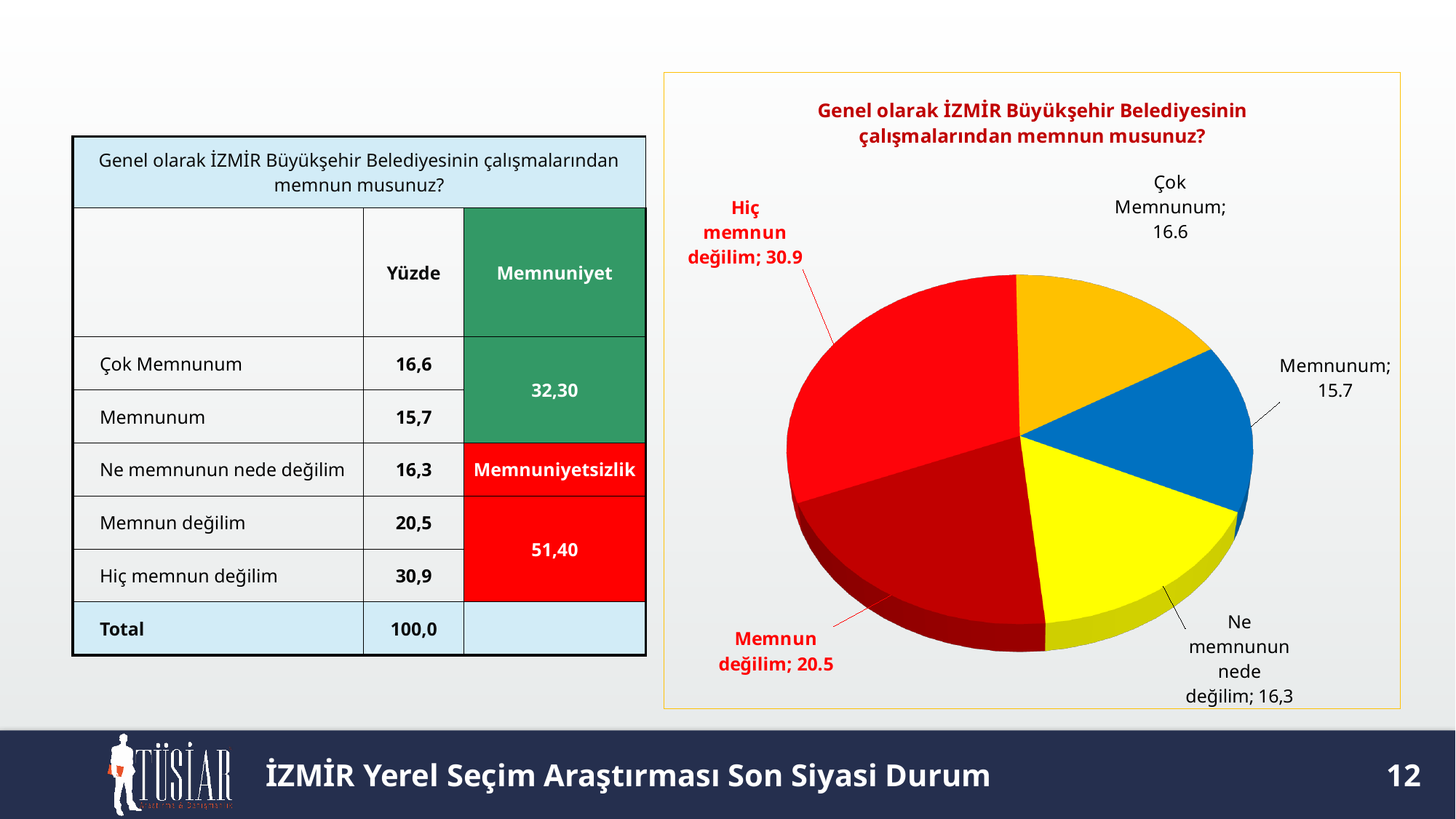
What is the value shown for Memnunum in the pie chart? 15.7 How many slices does the pie chart have? 5 What is the value shown for Ne memnunun nede değilim in the pie chart? 16,3 Which category has the largest slice in the pie chart? Hiç memnun değilim What is the value shown for Hiç memnun değilim in the pie chart? 30.9 What is the difference between the values for Hiç memnun değilim and Memnun değilim in the pie chart? 10.4 What is the value shown for Çok Memnunum in the pie chart? 16.6 What colour is the Hiç memnun değilim slice in the pie chart? Red What kind of chart is shown on the slide? Pie chart Which is larger in the pie chart, Memnun değilim or Çok Memnunum? Memnun değilim What is the difference between the values for Memnun değilim and Memnunum in the pie chart? 4.8 Which category has the smallest slice in the pie chart? Memnunum